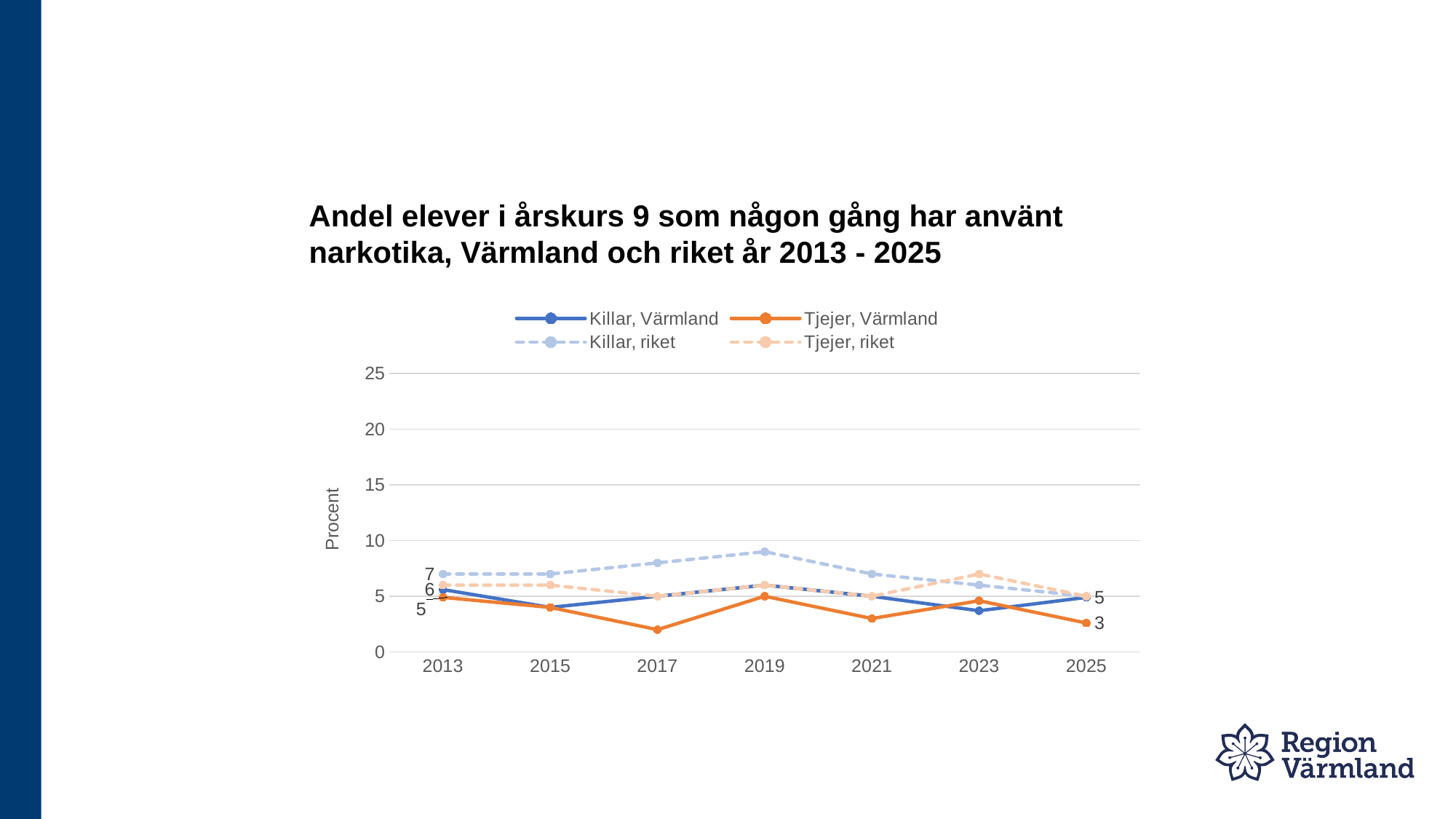
Is the value for Killar, riket in 2019 greater or less than 5? greater What is the value for Tjejer, Värmland in 2013? 5 How many years are shown on the x axis? 7 Is the value for Tjejer, Värmland in 2017 greater or less than 5? less What is the value for Killar, Värmland in 2013? 6 What is the value for Tjejer, Värmland in 2025? 3 In which year is the Killar, riket series at its highest? 2019 In 2025, which is larger: Killar, Värmland or Tjejer, Värmland? Killar, Värmland In which year is the Tjejer, Värmland series at its lowest? 2017 By how much did the value for Tjejer, Värmland change between 2013 and 2025? 2 How many series does the legend list? 4 What is the value for Killar, Värmland in 2025? 5